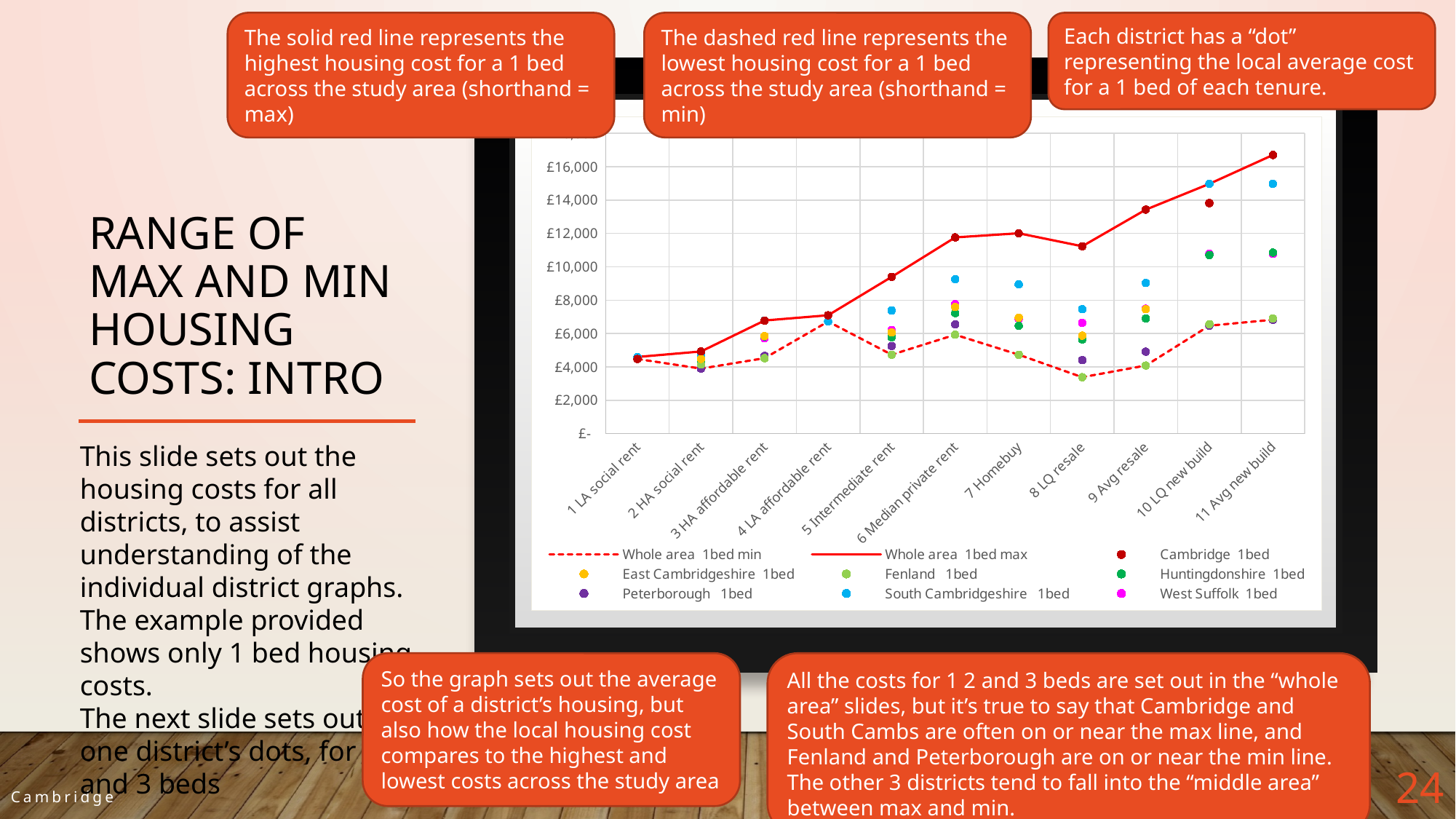
Which category has the highest value on the Whole area 1bed max line? 11 Avg new build How many categories are shown on the x axis of the chart? 11 How many series does the chart's legend list? 9 On the Whole area 1bed max line, which is larger: the value for 8 LQ resale or the value for 9 Avg resale? 9 Avg resale Is the Cambridge 1bed value for 10 LQ new build greater or less than £12,000? greater Is the Whole area 1bed max value for 6 Median private rent greater or less than £10,000? greater Which legend entry is drawn as a dashed red line? Whole area 1bed min Does the Whole area 1bed max line generally rise or fall from 1 LA social rent to 11 Avg new build? rise Is the Whole area 1bed min value for 8 LQ resale greater or less than £4,000? less Which category has the lowest value on the Whole area 1bed min line? 8 LQ resale What kind of chart is shown on the slide? line chart